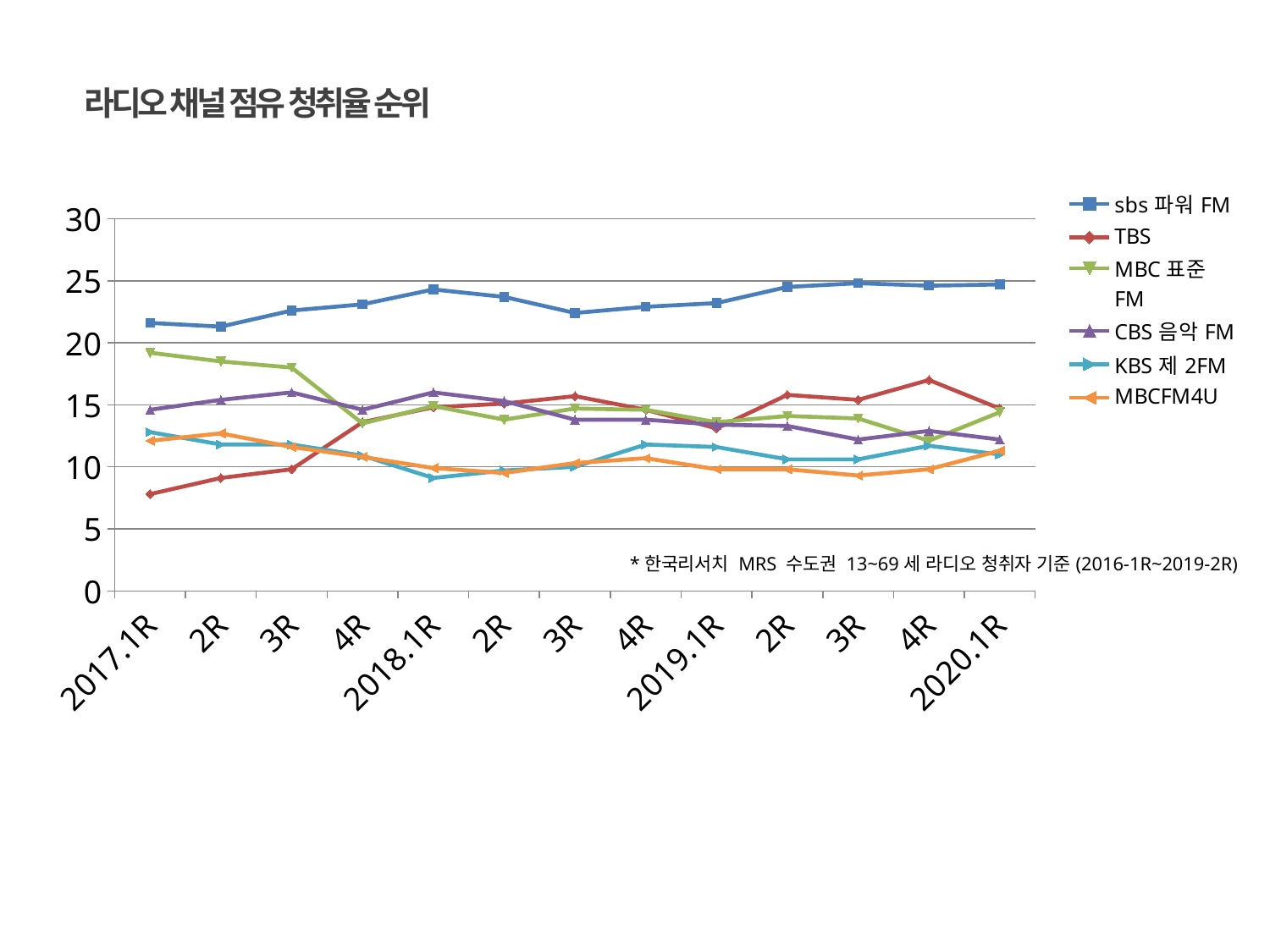
Which series has the highest value at 2020.1R? sbs 파워 FM What is the title of the chart? 라디오 채널 점유 청취율 순위 Is the value for KBS 제 2FM at 2018.1R greater or less than 10? less At 2019.4R, which is higher: TBS or CBS 음악 FM? TBS What kind of chart is shown on the slide? line chart Which series has the lowest value at 2017.1R? TBS Is the value for sbs 파워 FM at 2017.1R greater or less than 20? greater Is the value for MBC 표준 FM at 2017.1R greater or less than 15? greater How many points are there along the x axis? 13 Does the TBS line rise or fall overall from 2017.1R to 2019.4R? rise How many series does the legend list? 6